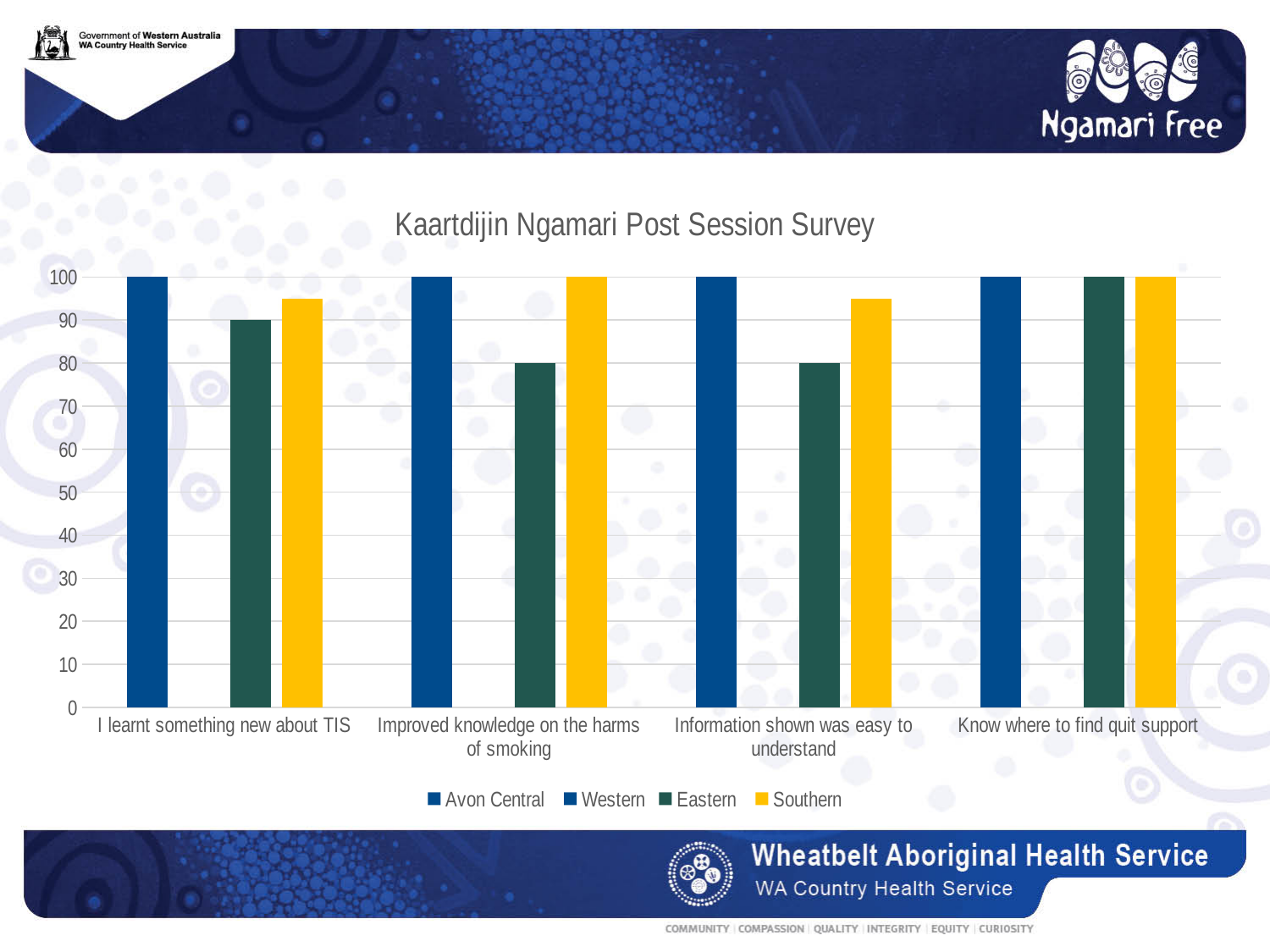
What kind of chart is shown on the slide? bar chart What is the Eastern value for "I learnt something new about TIS"? 90 For which category is the Eastern value highest? Know where to find quit support Is the Southern value for "I learnt something new about TIS" greater or less than 90? greater What is the difference between the Eastern values for "I learnt something new about TIS" and "Improved knowledge on the harms of smoking"? 10 How many survey statement categories are shown on the x axis? 4 What is the Eastern value for "Know where to find quit support"? 100 For "Information shown was easy to understand", which is larger: the Eastern value or the Southern value? Southern How many series does the legend list? 4 What is the Eastern value for "Improved knowledge on the harms of smoking"? 80 What is the Southern value for "Improved knowledge on the harms of smoking"? 100 What is the title of the chart? Kaartdijin Ngamari Post Session Survey